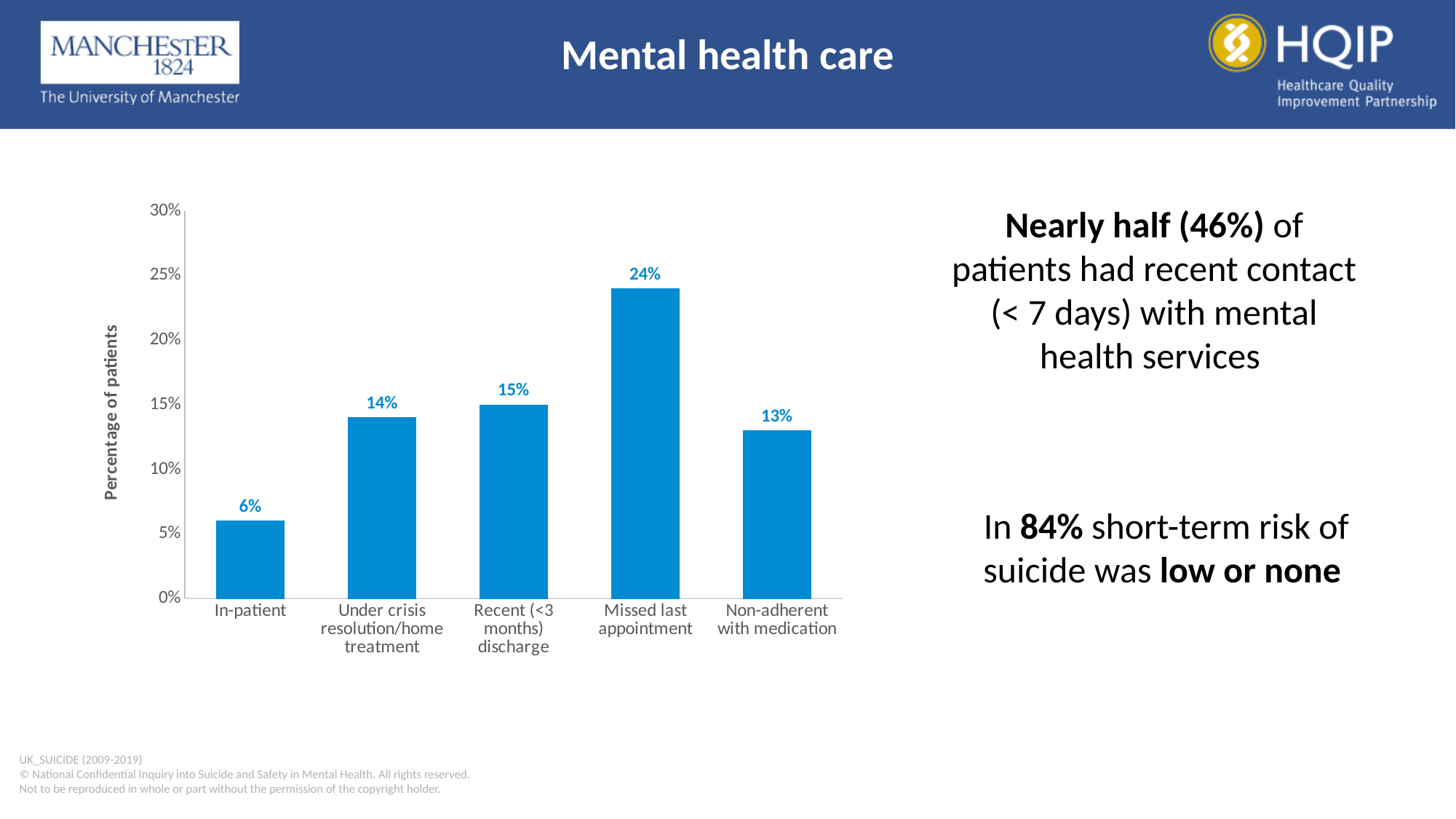
What percentage of patients were non-adherent with medication? 13% Which category has the lowest percentage of patients? In-patient How many categories are shown on the x axis of the chart? 5 What percentage of patients were in-patients? 6% What type of chart is shown on the slide? Bar chart What is the difference in percentage points between 'Missed last appointment' and 'In-patient'? 18% Which is larger: the value for 'Recent (<3 months) discharge' or 'Non-adherent with medication'? Recent (<3 months) discharge Which category has the highest percentage of patients? Missed last appointment What is the label of the vertical axis of the chart? Percentage of patients What percentage of patients had missed their last appointment? 24% Is the value for 'Missed last appointment' greater or less than 20%? greater What percentage of patients were under crisis resolution/home treatment? 14%